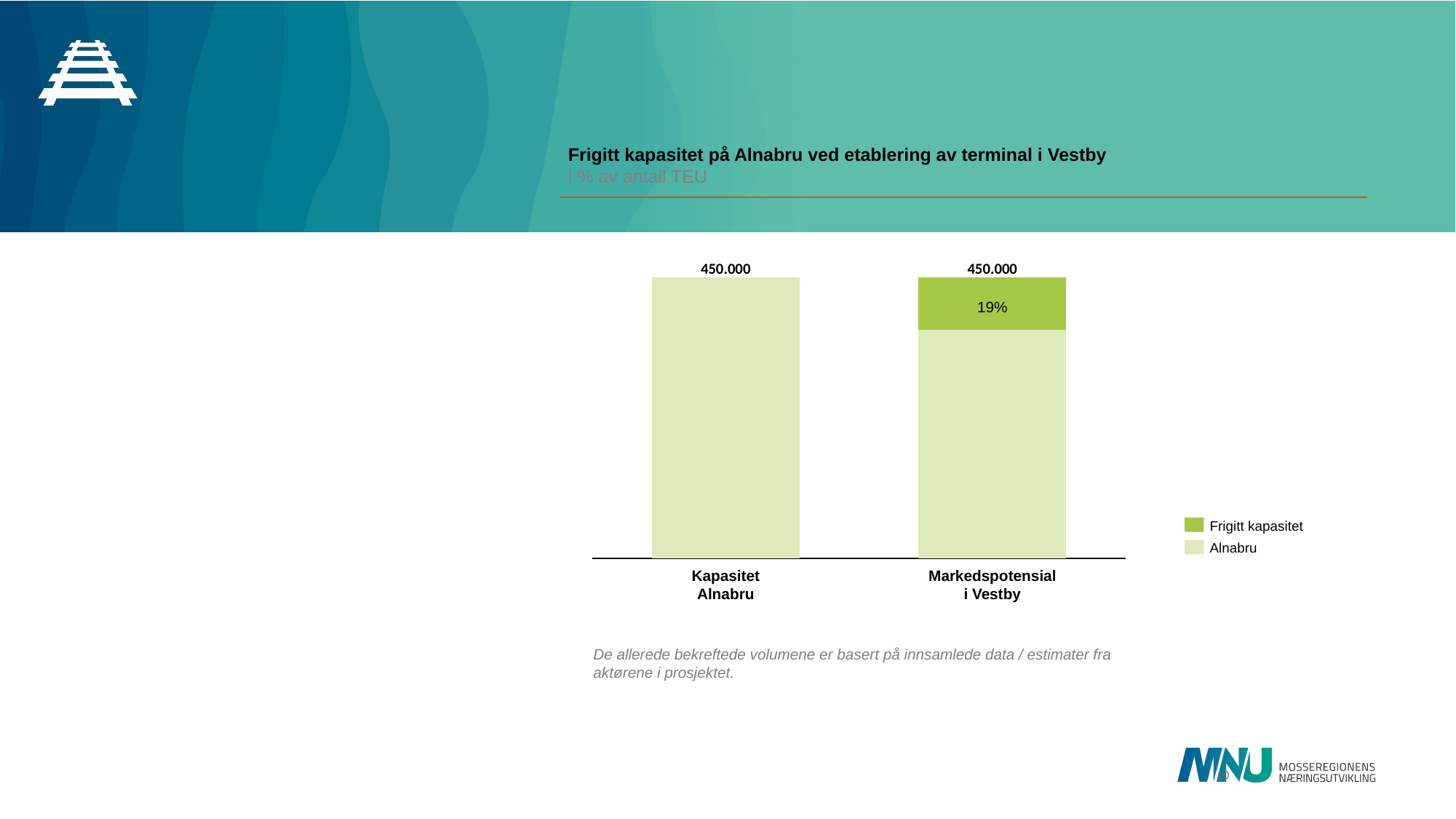
What total value is printed above the 'Kapasitet Alnabru' bar? 450.000 What percentage is labelled on the 'Frigitt kapasitet' segment of the 'Markedspotensial i Vestby' bar? 19% What total value is printed above the 'Markedspotensial i Vestby' bar? 450.000 What are the two category labels on the x axis? Kapasitet Alnabru and Markedspotensial i Vestby Which bar contains a 'Frigitt kapasitet' segment? Markedspotensial i Vestby How many series does the legend list? 2 Is the total for 'Kapasitet Alnabru' larger than, smaller than, or equal to the total for 'Markedspotensial i Vestby'? Equal How many bars (categories) does the chart show? 2 What are the two entries listed in the chart legend? Frigitt kapasitet and Alnabru What is the title of the chart? Frigitt kapasitet på Alnabru ved etablering av terminal i Vestby What kind of chart is shown on the slide? Stacked bar chart